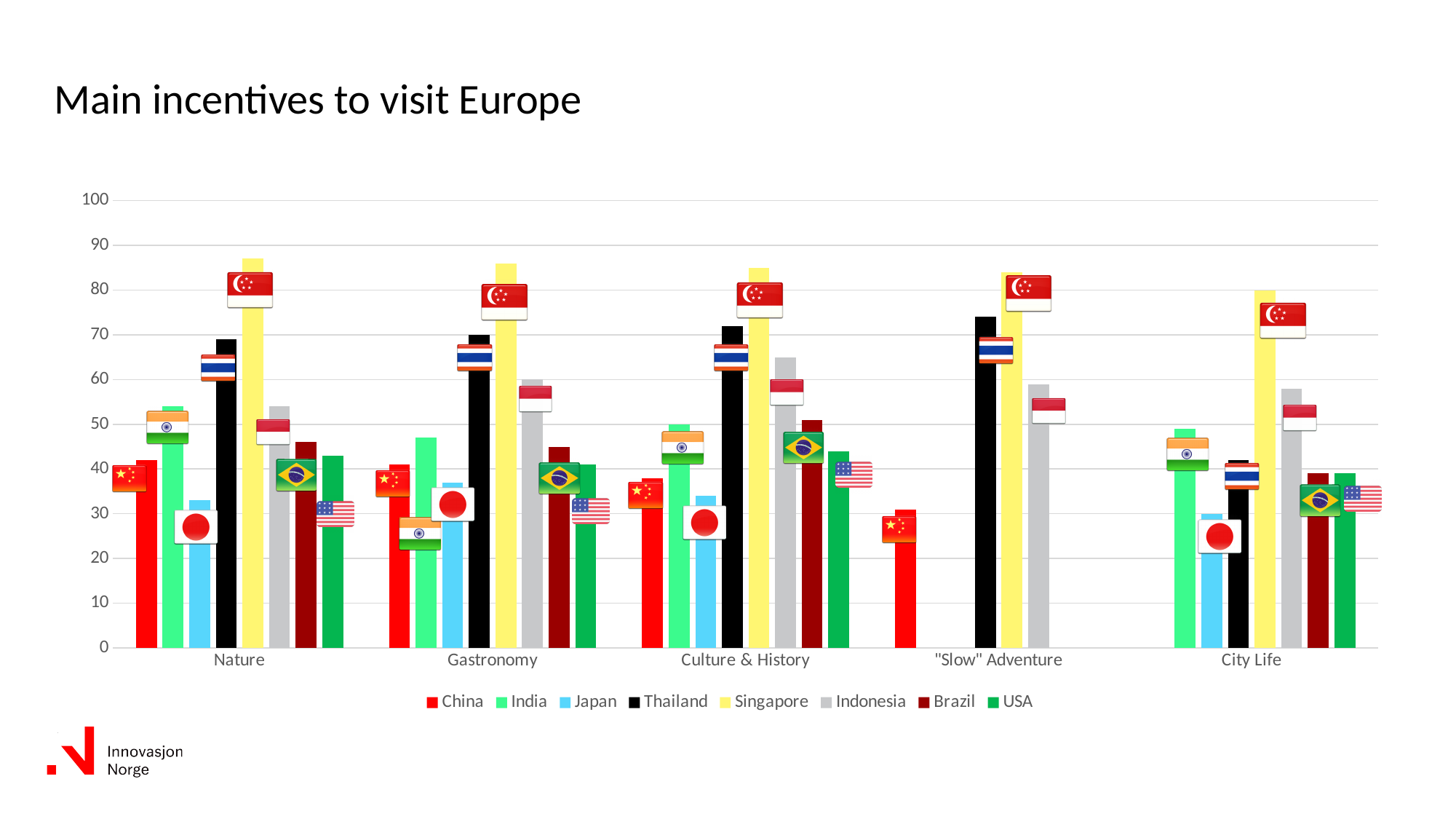
How many incentive categories are shown on the x axis? 5 Which country has the highest value for Nature? Singapore How many series does the legend list? 8 Which is larger in "Slow" Adventure, the value for Thailand or the value for Indonesia? Thailand What kind of chart is shown on the slide? bar chart Is the value for China in "Slow" Adventure greater or less than 40? less Which is larger in Gastronomy, the value for India or the value for Japan? India Is the value for Singapore in Nature greater or less than 80? greater Which country has the lowest value for City Life? Japan What is the title of the chart? Main incentives to visit Europe Which country has the lowest value for Nature? Japan Is the value for Thailand in "Slow" Adventure greater or less than 70? greater